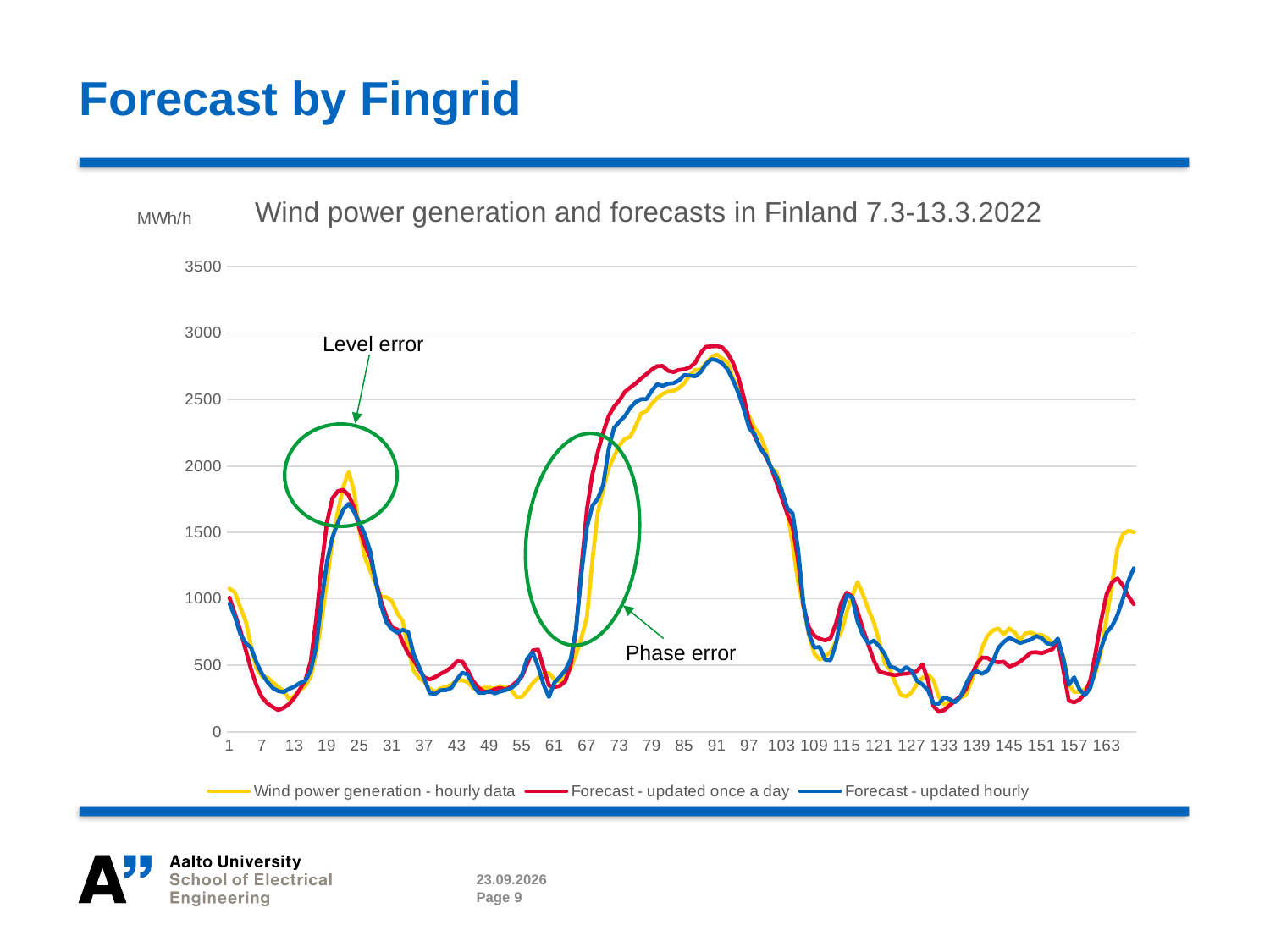
How many series does the legend list? 3 Is the value of Forecast - updated hourly at x = 37 greater or less than 500? less What is the title of the chart? Wind power generation and forecasts in Finland 7.3-13.3.2022 Is the value of Forecast - updated once a day at x = 133 greater or less than 500? less What kind of chart is shown on the slide? Line chart Do the plotted values rise or fall between x = 91 and x = 109? fall Is the value of Wind power generation - hourly data at x = 91 greater or less than 2500? greater What is the highest value labelled on the y axis? 3500 What is the last label shown on the x axis? 163 Do the plotted values rise or fall between x = 61 and x = 85? rise What unit is shown on the y axis of the chart? MWh/h